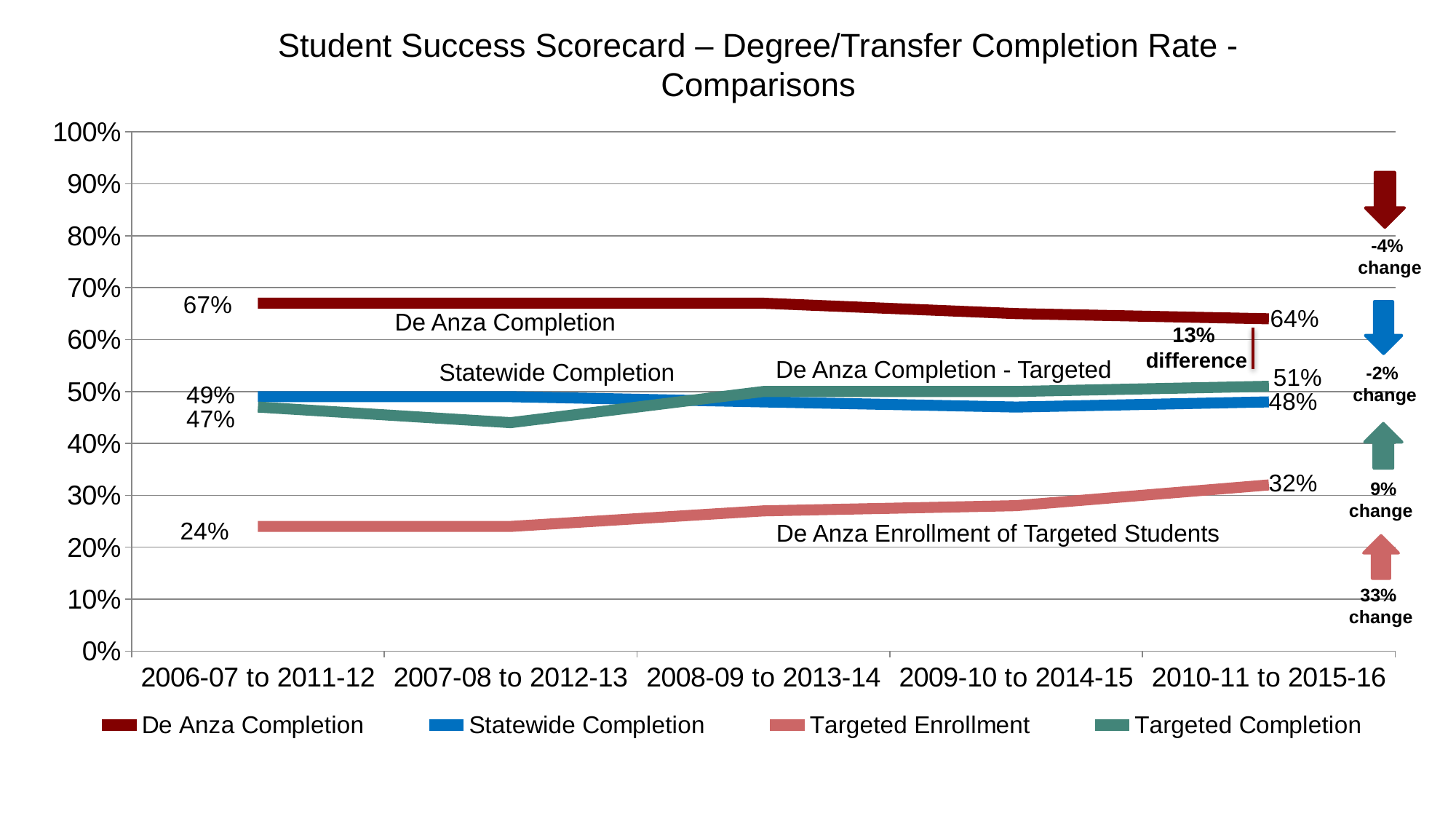
What is the difference between De Anza Completion and Statewide Completion in 2010-11 to 2015-16? 16% What type of chart is shown on the slide? line chart How many periods are shown along the x axis? 5 What is the De Anza Completion value for 2010-11 to 2015-16? 64% Does the Targeted Enrollment series rise or fall across the periods on the x axis? rise Is the Statewide Completion value for 2008-09 to 2013-14 greater or less than 60%? less What is the Targeted Enrollment value for 2010-11 to 2015-16? 32% Which series has the highest value in 2010-11 to 2015-16? De Anza Completion How many series does the legend list? 4 Which series has the lowest value in 2006-07 to 2011-12? Targeted Enrollment What is the Targeted Completion value for 2006-07 to 2011-12? 47% What is the De Anza Completion value for 2006-07 to 2011-12? 67%